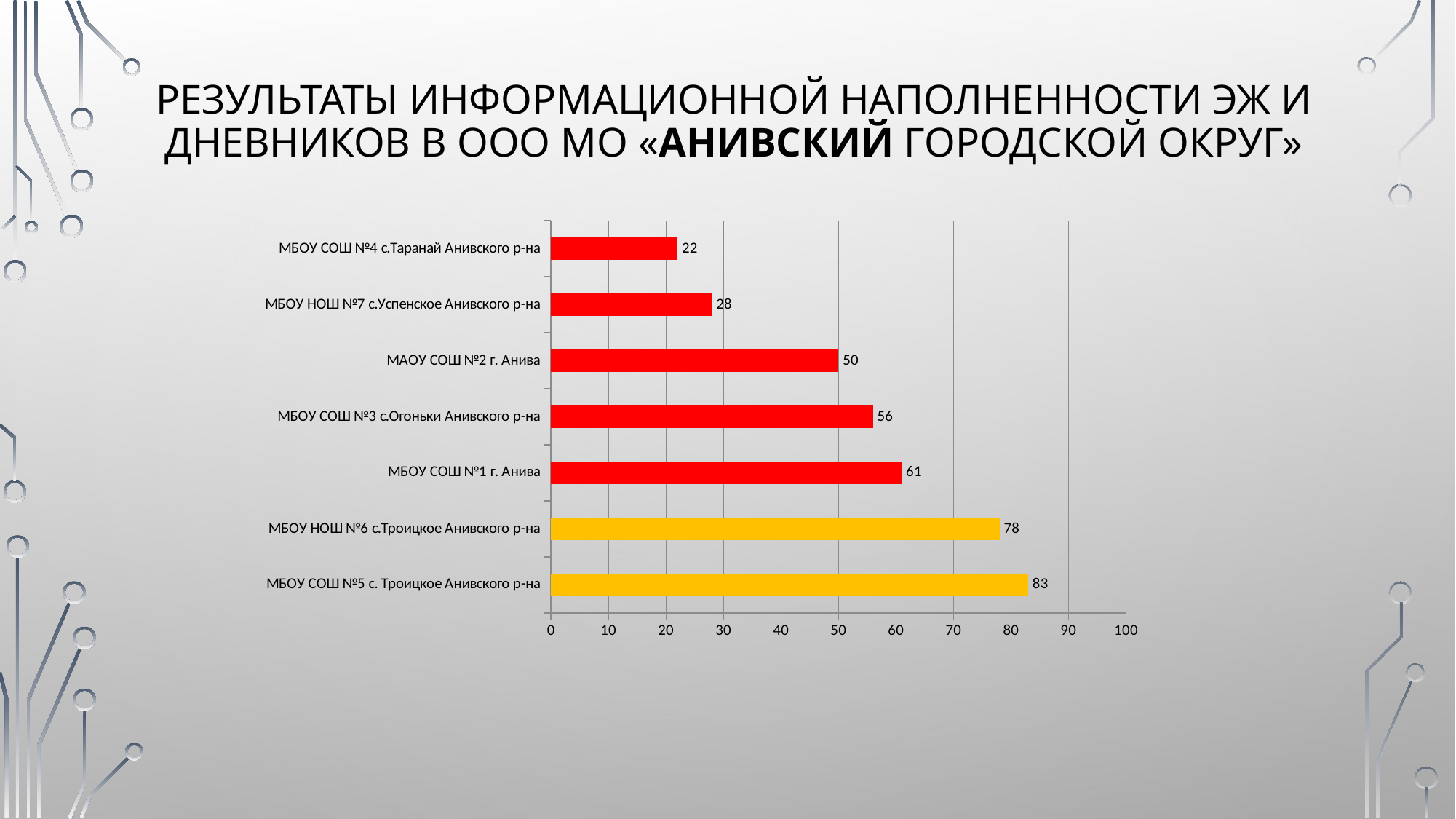
Which has a larger value: МБОУ СОШ №3 с.Огоньки Анивского р-на or МБОУ НОШ №7 с.Успенское Анивского р-на? МБОУ СОШ №3 с.Огоньки Анивского р-на What kind of chart is shown on the slide? Bar chart What is the difference between the values for МБОУ НОШ №6 с.Троицкое Анивского р-на and МБОУ СОШ №1 г. Анива? 17 What is the value for МБОУ СОШ №5 с. Троицкое Анивского р-на? 83 How many schools are shown in the chart? 7 How many bars are coloured yellow? 2 Is the value for МБОУ СОШ №1 г. Анива greater or less than 50? greater What is the value for МБОУ СОШ №4 с.Таранай Анивского р-на? 22 Which school has the lowest value? МБОУ СОШ №4 с.Таранай Анивского р-на Which school has the highest value? МБОУ СОШ №5 с. Троицкое Анивского р-на What is the value for МАОУ СОШ №2 г. Анива? 50 What is the maximum value shown on the horizontal axis? 100